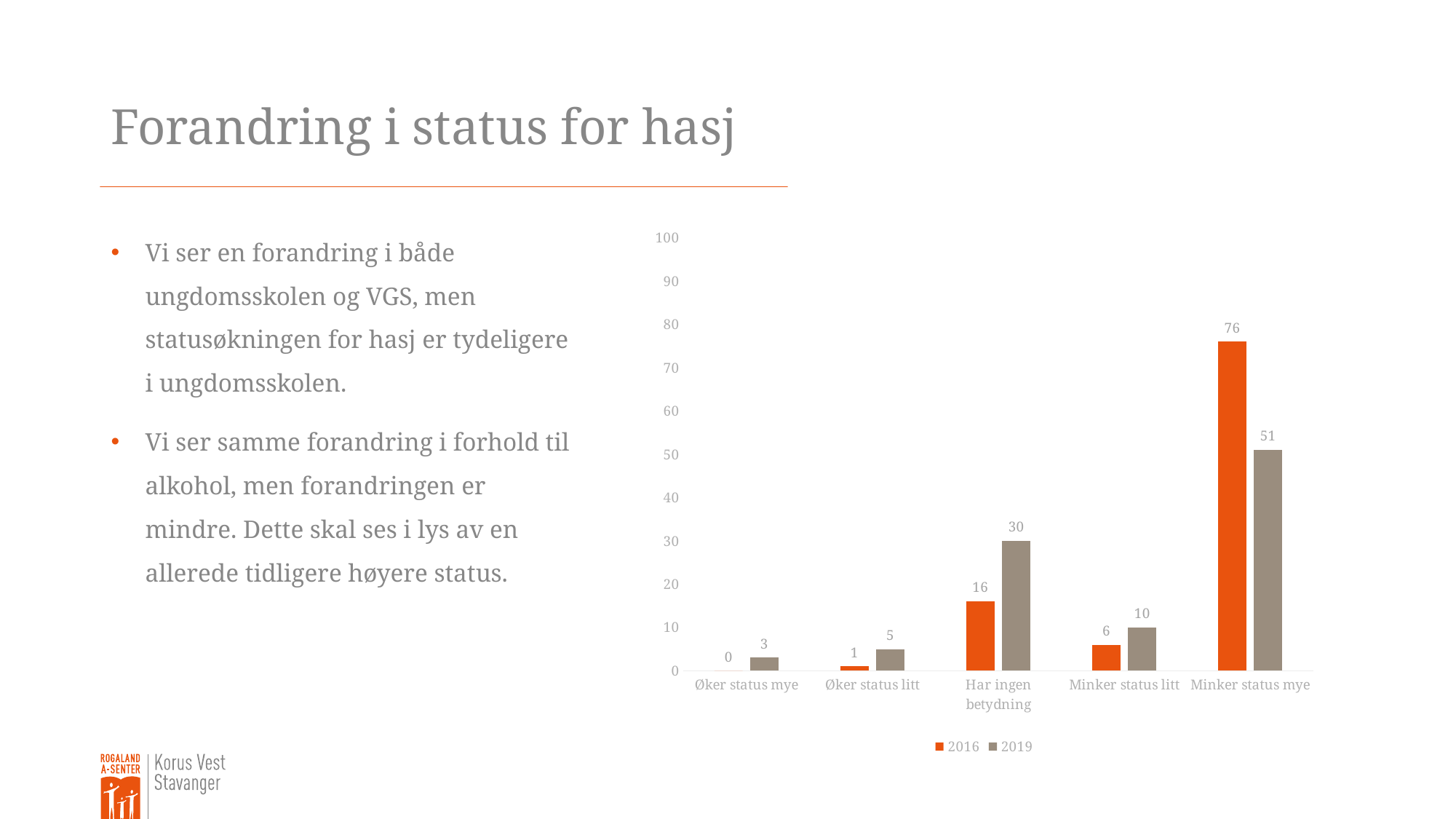
Is the value for 2019 in "Minker status mye" greater or less than 60? less How many categories are shown on the x axis? 5 What is the value for 2016 in the "Øker status mye" category? 0 How many series does the legend list? 2 What is the value for 2016 in the "Minker status mye" category? 76 Which series is shown in orange? 2016 What is the value for 2019 in the "Har ingen betydning" category? 30 Which category has the lowest value for 2016? Øker status mye What is the difference between the 2016 and 2019 values for "Minker status mye"? 25 Which category has the highest value for 2019? Minker status mye What kind of chart is shown on the slide? Bar chart Which is larger for "Har ingen betydning": the 2016 value or the 2019 value? 2019